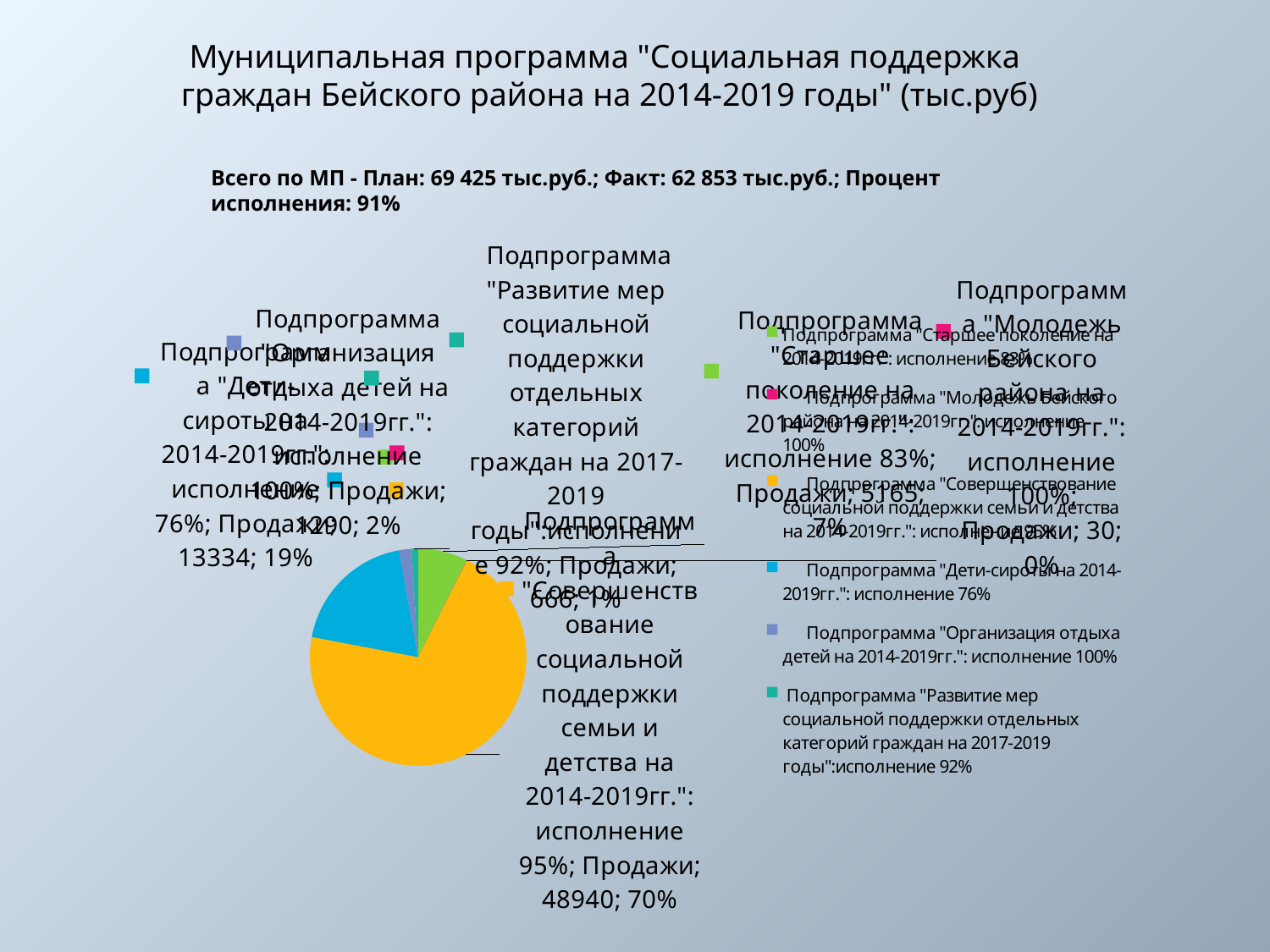
Which is larger: the value for "Старшее поколение на 2014-2019гг." or the value for "Организация отдыха детей на 2014-2019гг."? Старшее поколение на 2014-2019гг. Which subprogram has the smallest slice of the pie? Подпрограмма "Молодежь Бейского района на 2014-2019гг." What is the value shown for the subprogram "Дети-сироты на 2014-2019гг."? 13334 What execution percentage (исполнение) is shown in the legend for the subprogram "Старшее поколение на 2014-2019гг."? 83% What kind of chart is shown on the slide? pie chart What is the value shown for the subprogram "Молодежь Бейского района на 2014-2019гг."? 30 What is the difference between the values for "Организация отдыха детей на 2014-2019гг." and "Развитие мер социальной поддержки отдельных категорий граждан на 2017-2019 годы"? 624 What is the value shown for the subprogram "Старшее поколение на 2014-2019гг."? 5165 What is the value shown for the subprogram "Совершенствование социальной поддержки семьи и детства на 2014-2019гг."? 48940 How many slices (subprograms) does the pie chart have? 6 Which subprogram has the largest slice of the pie? Подпрограмма "Совершенствование социальной поддержки семьи и детства на 2014-2019гг." What share of the pie does the subprogram "Дети-сироты на 2014-2019гг." take? 19%